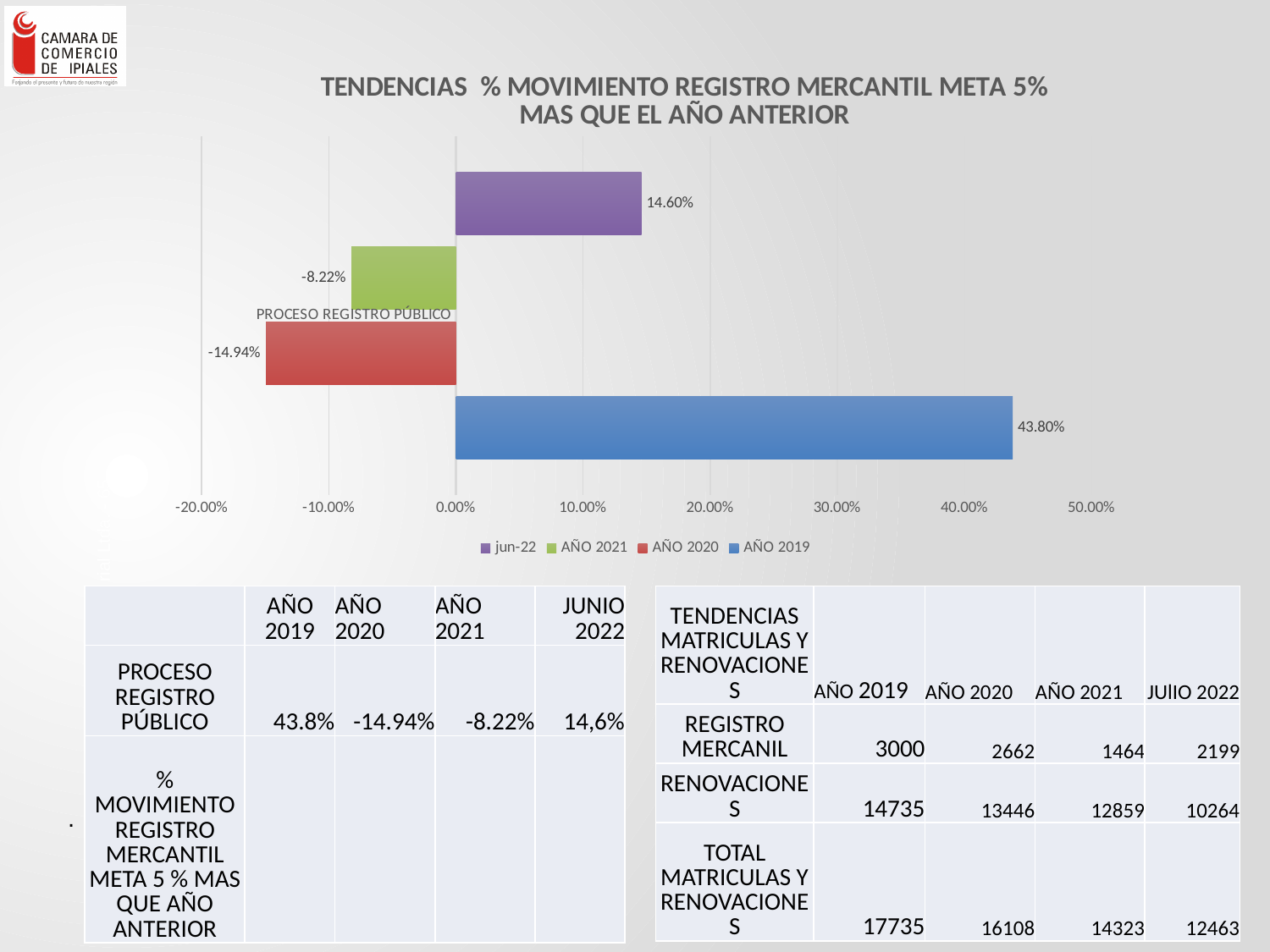
What is the difference between the AÑO 2019 value and the jun-22 value? 29.20% What is the value for AÑO 2019 in the chart? 43.80% What is the value for jun-22 in the chart? 14.60% What type of chart is shown on the slide? bar chart What is the value for AÑO 2021 in the chart? -8.22% Which is larger, the value for jun-22 or the value for AÑO 2021? jun-22 Is the value for AÑO 2019 greater or less than 40.00%? greater Which series has the lowest value in the chart? AÑO 2020 What is the value for AÑO 2020 in the chart? -14.94% What is the title of the chart? TENDENCIAS % MOVIMIENTO REGISTRO MERCANTIL META 5% MAS QUE EL AÑO ANTERIOR Which series has the highest value in the chart? AÑO 2019 How many series does the legend list? 4